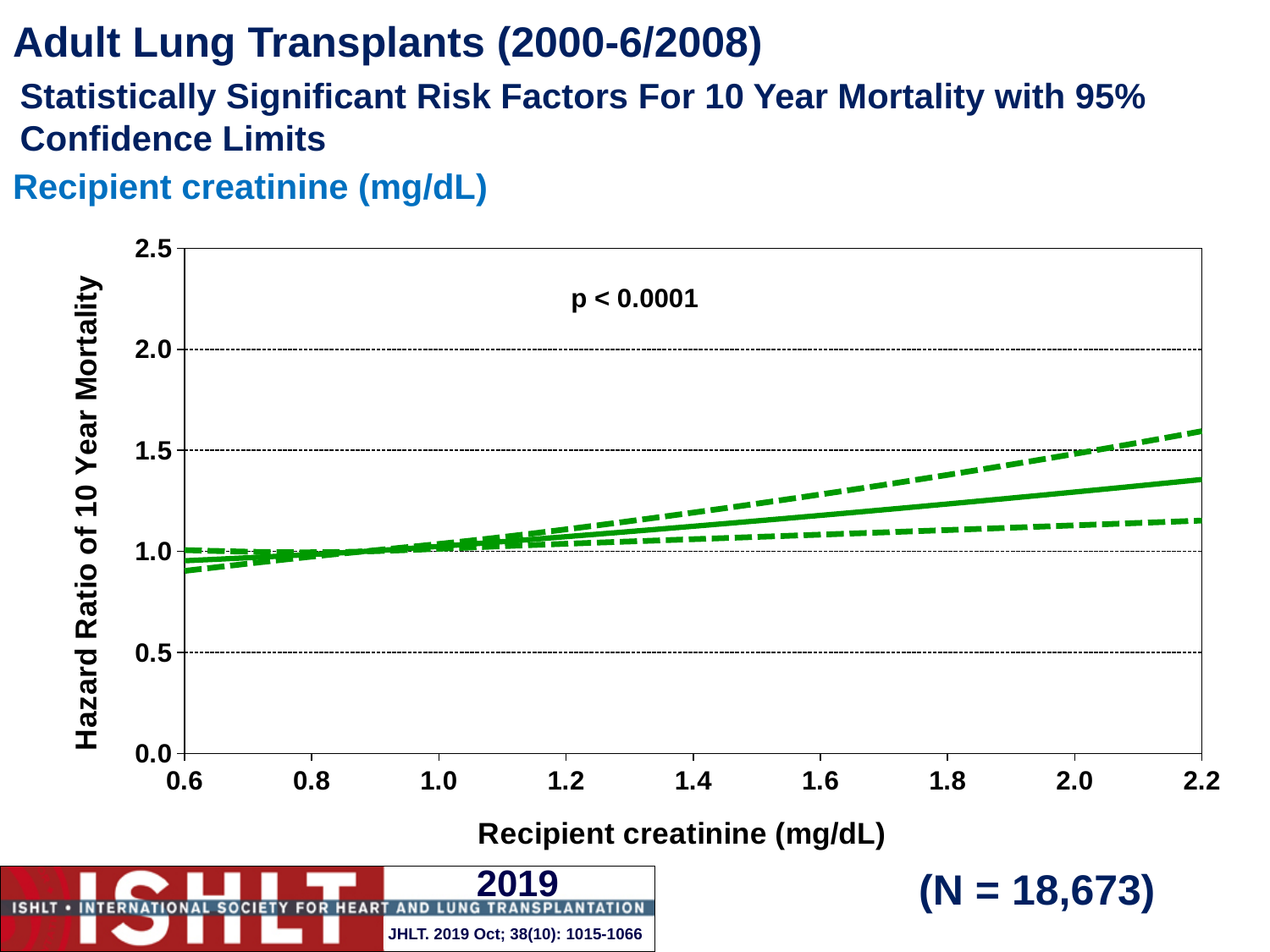
Is the hazard ratio (solid line) at a recipient creatinine of 2.2 mg/dL greater or less than 1.5? less Is the upper 95% confidence limit (upper dashed line) at a recipient creatinine of 2.2 mg/dL greater or less than 1.5? greater Is the lower 95% confidence limit (lower dashed line) at a recipient creatinine of 2.2 mg/dL greater or less than 1.5? less What p-value is printed on the chart? p < 0.0001 What is the sample size (N) shown on the slide? 18,673 Does the hazard ratio of 10 year mortality rise or fall as recipient creatinine increases from 0.6 to 2.2 mg/dL? rise How many tick labels are shown on the x axis of the chart? 9 How many lines are plotted on the chart? 3 What kind of chart is shown on the slide? line chart